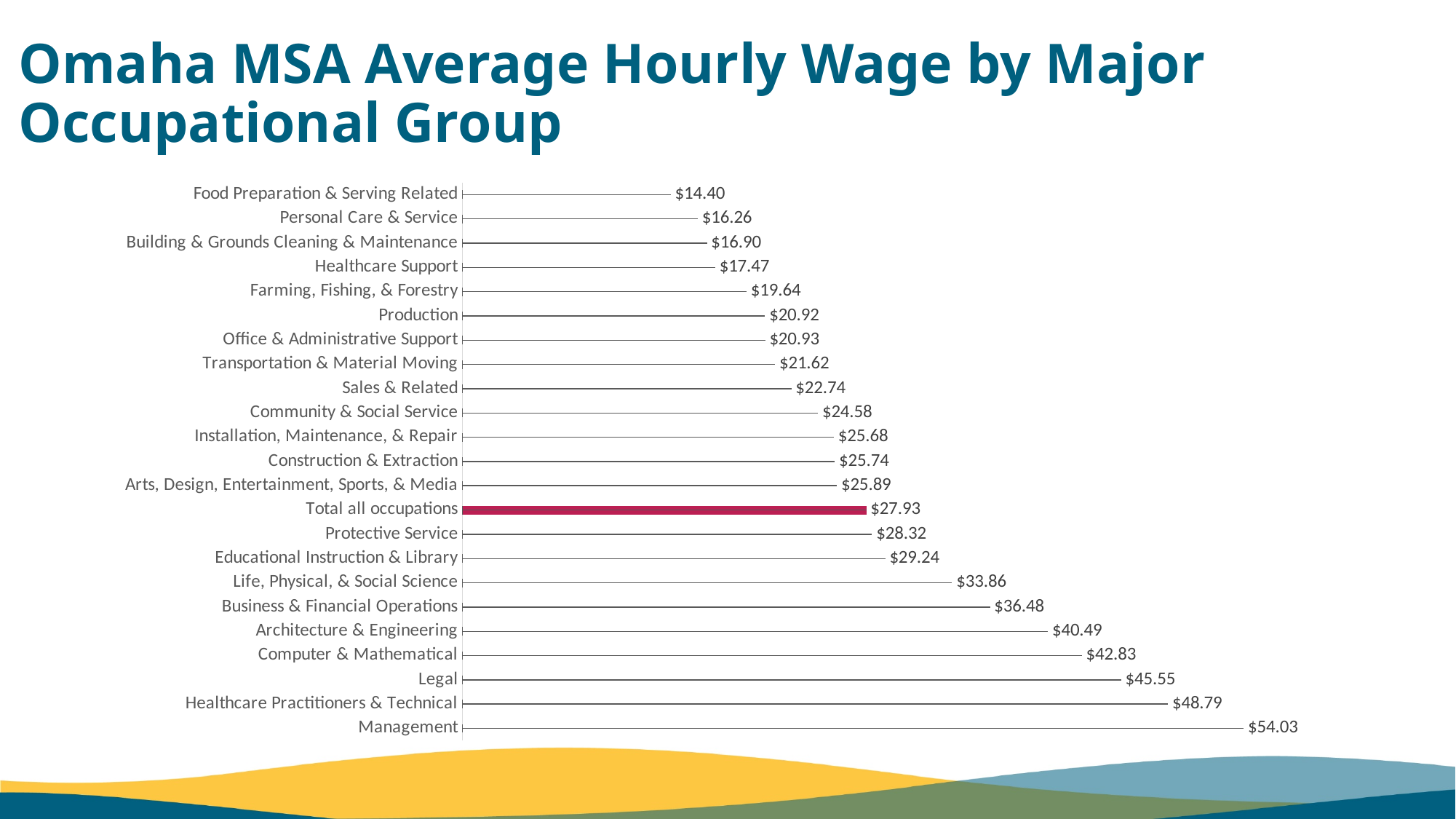
What is the average hourly wage for Computer & Mathematical? $42.83 How many occupational groups (including Total all occupations) are shown on the chart? 23 What is the average hourly wage for Total all occupations? $27.93 Which bar on the chart is highlighted in a different colour (red) from the others? Total all occupations What is the average hourly wage for Healthcare Support? $17.47 Which occupational group has the lowest average hourly wage? Food Preparation & Serving Related What is the difference in average hourly wage between Legal and Computer & Mathematical? $2.72 Which has a higher average hourly wage, Business & Financial Operations or Life, Physical, & Social Science? Business & Financial Operations What kind of chart is shown on the slide? Bar chart What is the difference in average hourly wage between Management and Food Preparation & Serving Related? $39.63 Which occupational group has the highest average hourly wage? Management What is the average hourly wage for Management? $54.03